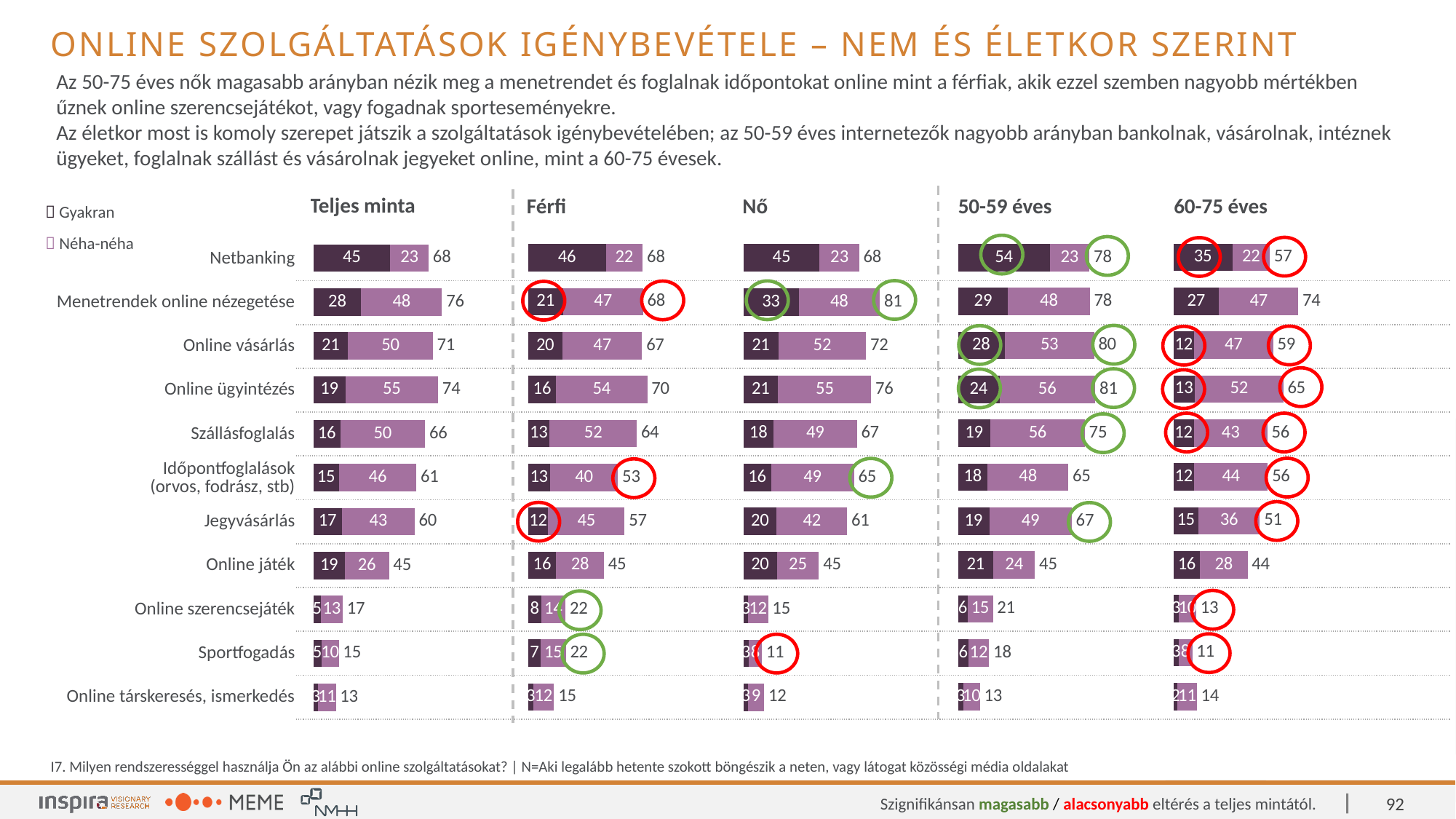
In the Férfi chart, what is the total for Menetrendek online nézegetése? 68 In the Teljes minta chart, what is the Néha-néha value for Online ügyintézés? 55 How many categories (online services) are shown in the Teljes minta chart? 11 In the 60-75 éves chart, what is the total for Online vásárlás? 59 In the Teljes minta chart, what is the Gyakran value for Netbanking? 45 In the Nő chart, what is the total for Menetrendek online nézegetése? 81 How many series does the legend list? 2 What is the difference between the Nő total and the Férfi total for Menetrendek online nézegetése? 13 In the 50-59 éves chart, what is the Gyakran value for Netbanking? 54 In the Teljes minta chart, which category has the lowest total? Online társkeresés, ismerkedés For Online ügyintézés, which group has the larger total: 50-59 éves or 60-75 éves? 50-59 éves In the Teljes minta chart, which category has the highest total? Menetrendek online nézegetése